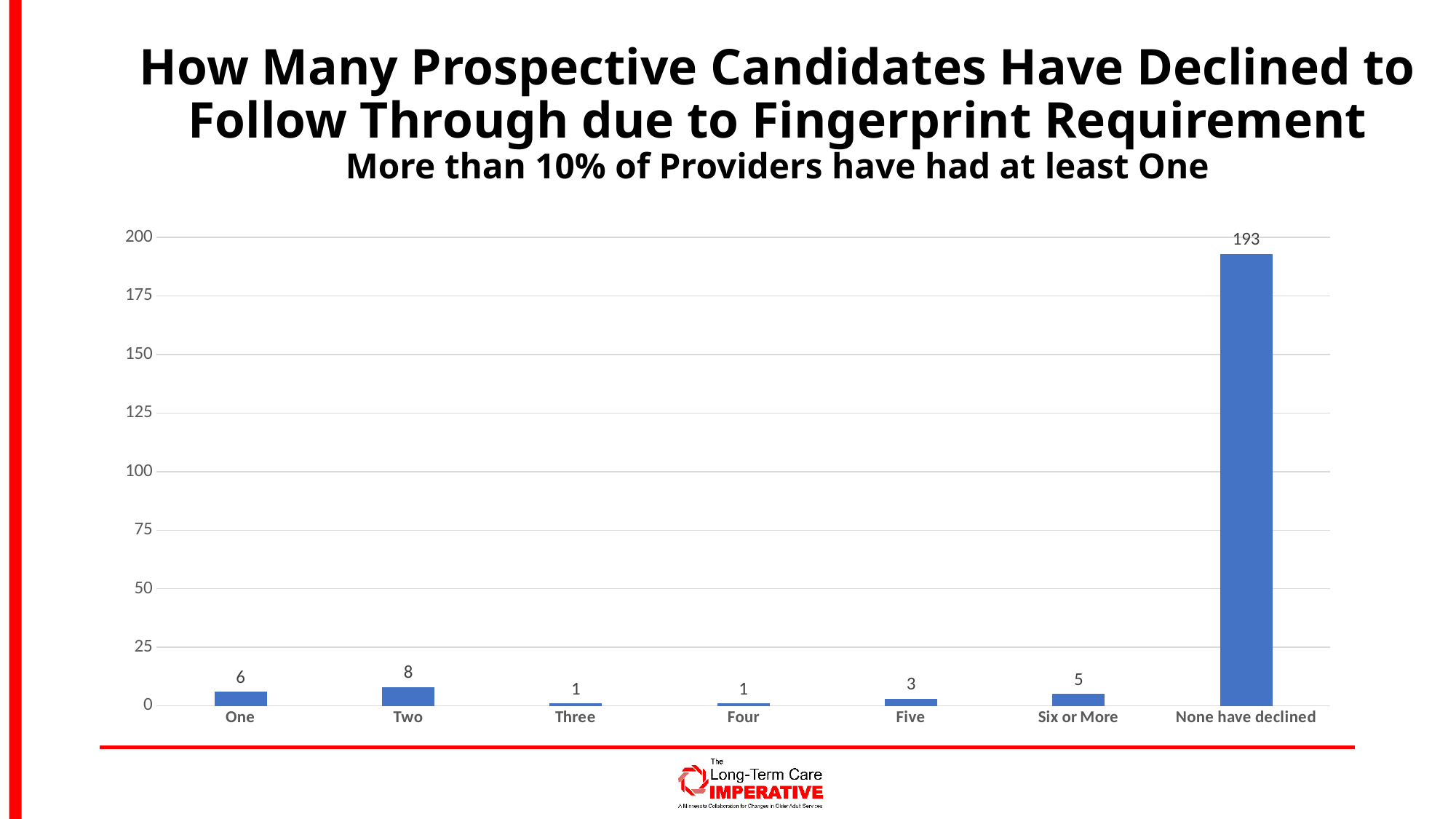
How many categories are shown on the x axis? 7 What is the subtitle shown below the chart title? More than 10% of Providers have had at least One What is the value for the "Five" category? 3 Is the value for "None have declined" greater or less than 175? greater What is the value for the "Six or More" category? 5 What is the value for the "None have declined" category? 193 What is the difference between the values for "None have declined" and "Two"? 185 What is the difference between the values for "Two" and "One"? 2 Which is larger, the value for "One" or the value for "Six or More"? One What kind of chart is shown on the slide? Bar chart What is the value for the "Two" category? 8 Which category has the highest value? None have declined